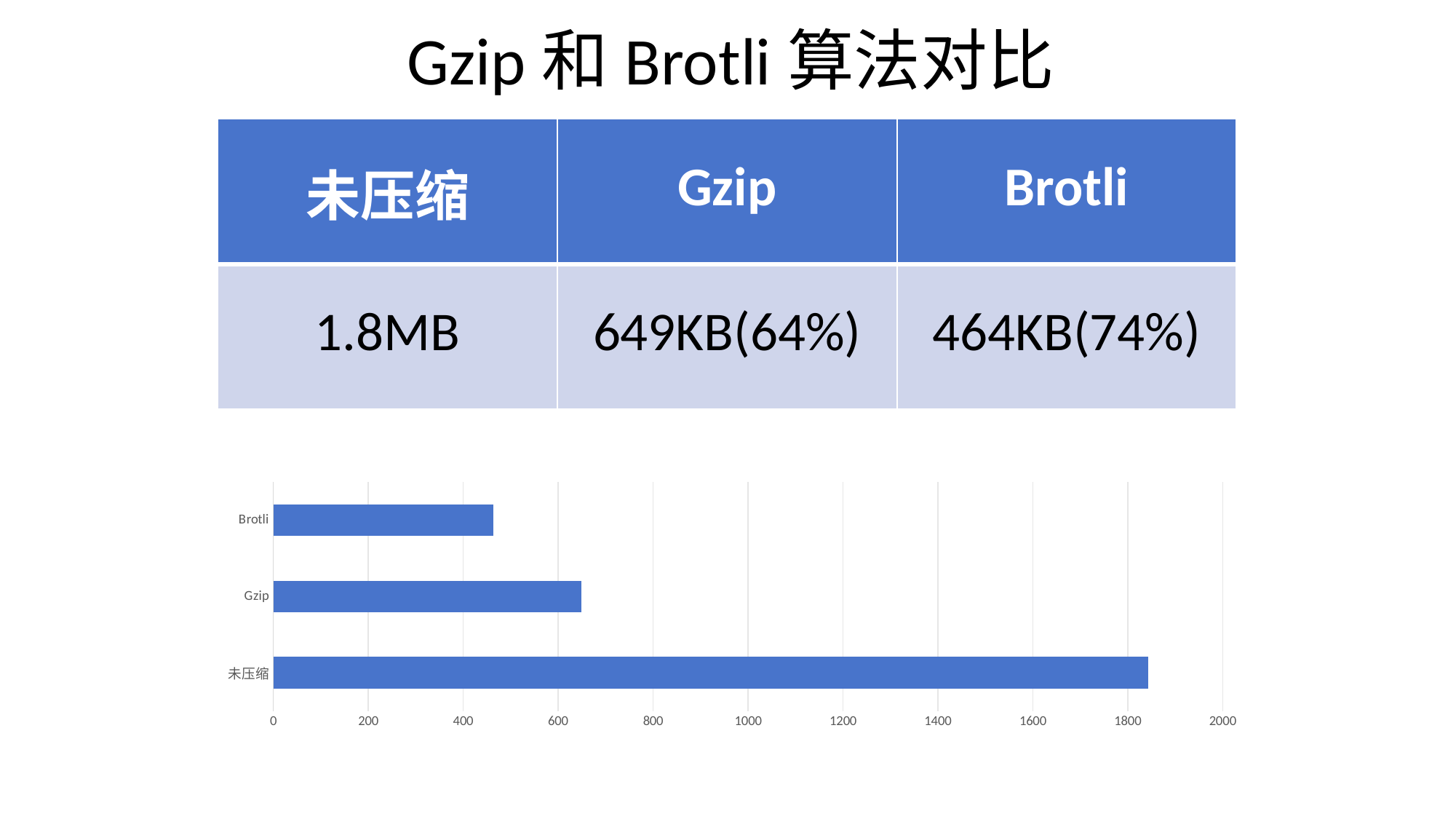
Is the value for Brotli greater or less than 600? less Is the bar for Gzip longer or shorter than the bar for Brotli? longer Is the value for Gzip greater or less than 600? greater Which category has the longest bar in the chart? 未压缩 Is the value for 未压缩 greater or less than 1600? greater Which category has the shortest bar in the chart? Brotli What colour are the bars in the chart? blue What is the maximum value shown on the chart's horizontal axis? 2000 What kind of chart is shown on the slide? bar chart How many categories does the bar chart show? 3